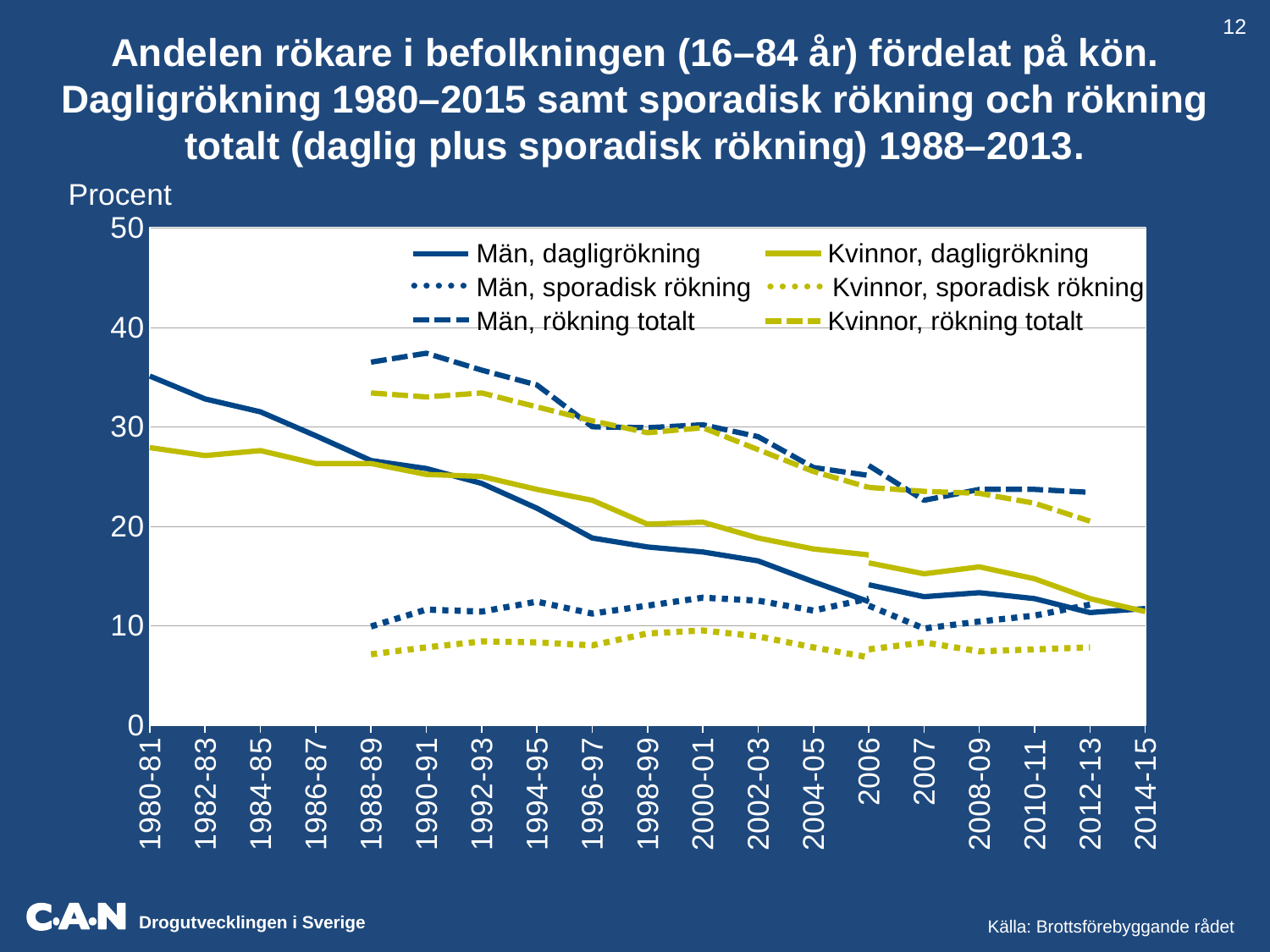
What label is shown on the y axis of the chart? Procent Does the value for 'Män, dagligrökning' rise or fall from 1980-81 to 2014-15? fall Is the value for 'Män, dagligrökning' in 1980-81 greater or less than 30? greater Is the value for 'Kvinnor, dagligrökning' in 1980-81 greater or less than 30? less In 1980-81, which is higher: 'Män, dagligrökning' or 'Kvinnor, dagligrökning'? Män, dagligrökning Is the value for 'Män, rökning totalt' in 1990-91 greater or less than 30? greater Does the value for 'Kvinnor, dagligrökning' rise or fall from 1980-81 to 2014-15? fall How many series does the legend list? 6 What kind of chart is shown on the slide? line chart How many year labels are shown along the x axis? 19 In 2008-09, which is higher: 'Män, dagligrökning' or 'Kvinnor, dagligrökning'? Kvinnor, dagligrökning